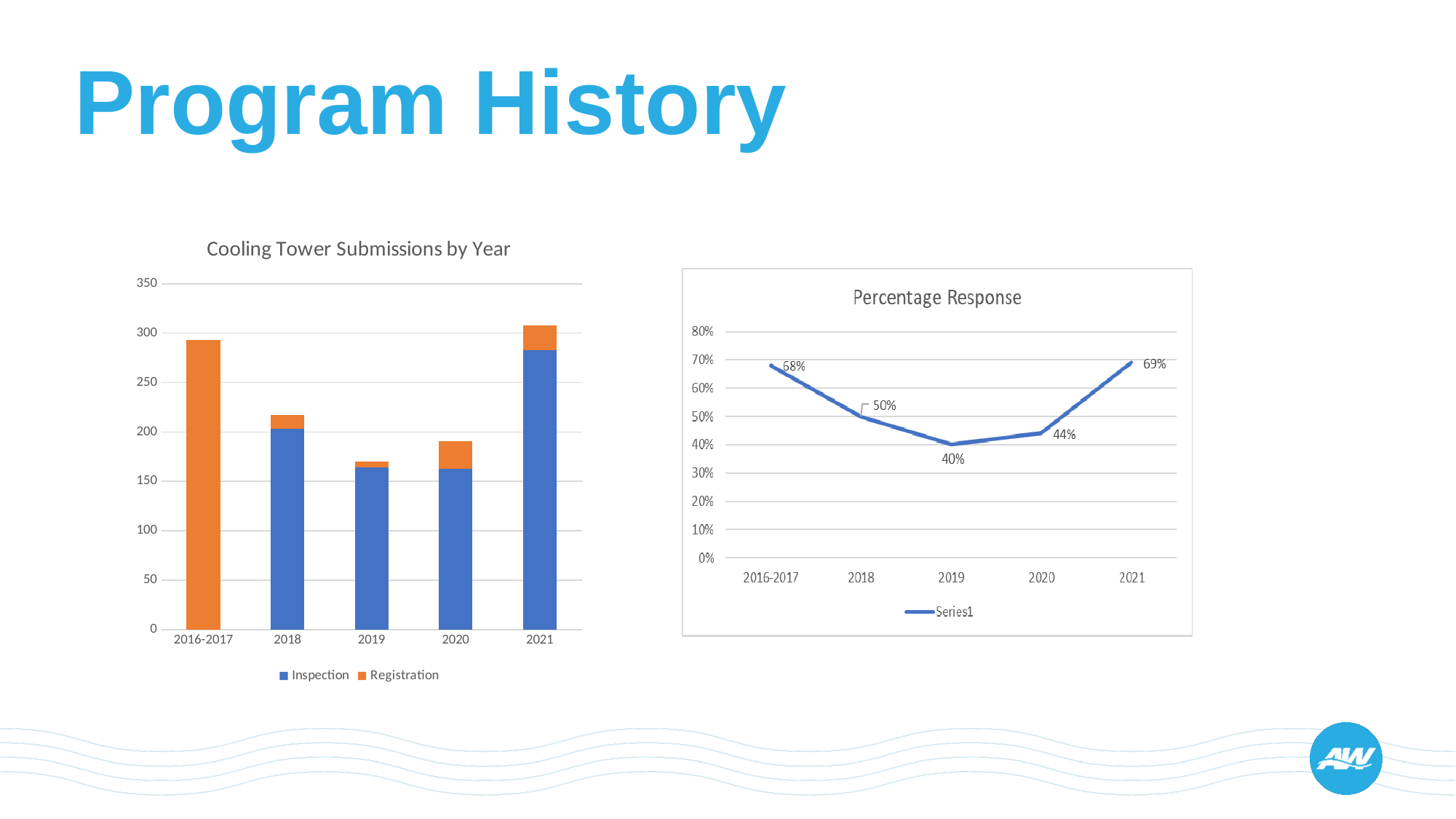
In the Cooling Tower Submissions by Year chart, is the Inspection value for 2019 greater or less than 200? less In the Percentage Response chart, what is the value for 2020? 44% What kind of chart is the Cooling Tower Submissions by Year chart? Stacked bar chart In the Percentage Response chart, how does the value change from 2016-2017 to 2019? It falls In the Percentage Response chart, what is the difference between the 2018 value and the 2019 value? 10 percentage points In the Cooling Tower Submissions by Year chart, is the total for 2021 greater or less than 300? greater In the Percentage Response chart, which year has the highest value? 2021 In the Percentage Response chart, what is the value for 2016-2017? 68% In the Percentage Response chart, what is the value for 2019? 40% In the Percentage Response chart, which year has the lowest value? 2019 How many series does the legend of the Cooling Tower Submissions by Year chart list? 2 In the Cooling Tower Submissions by Year chart, which year has the tallest stacked bar? 2021